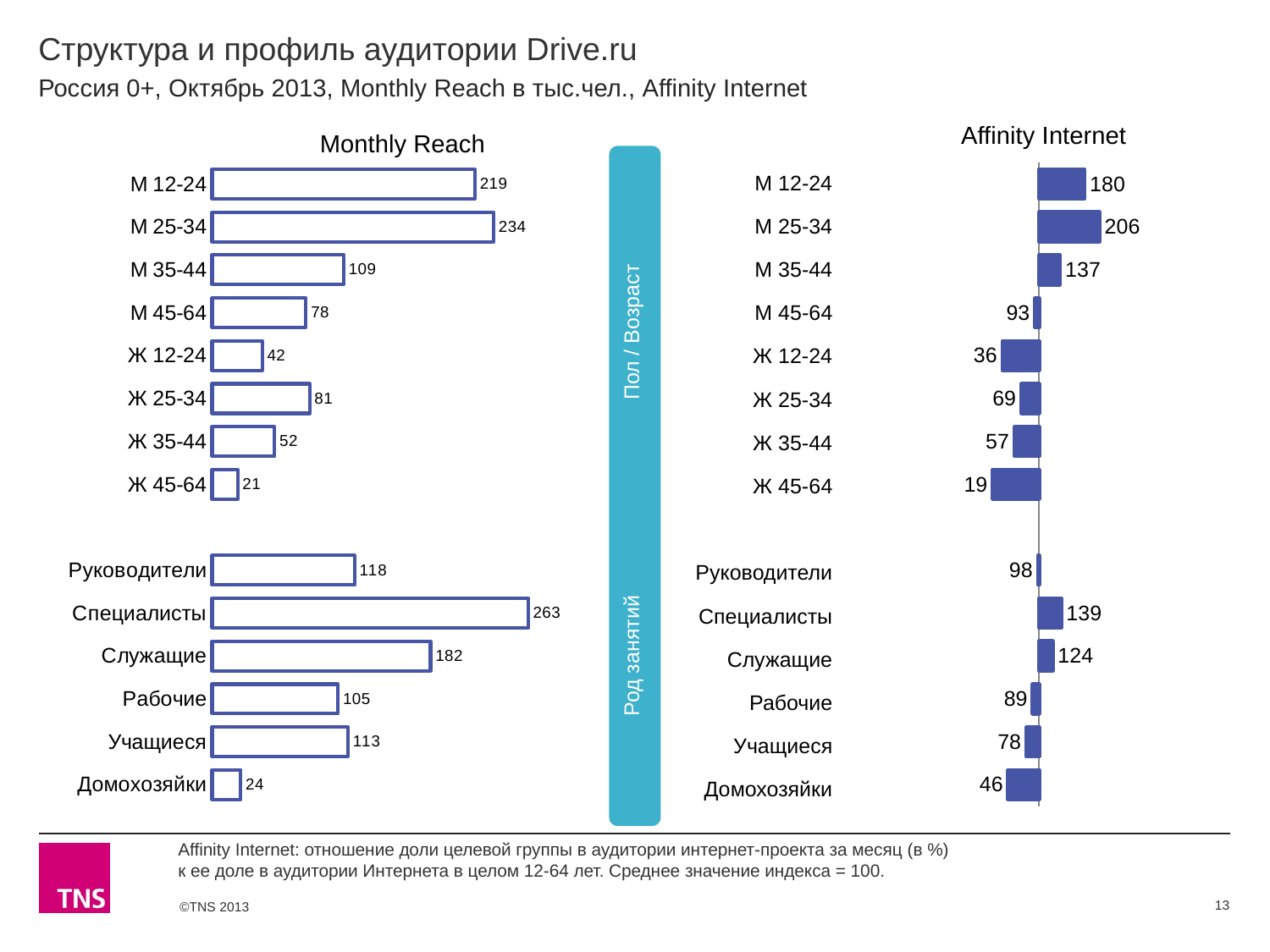
How many categories are plotted in the Monthly Reach chart? 14 In the Monthly Reach chart, what is the difference between Специалисты and Служащие? 81 In the Affinity Internet chart, what is the value for Ж 45-64? 19 What kind of chart is the Affinity Internet chart? Bar chart In the Affinity Internet chart, which category has the lowest value? Ж 45-64 In the Affinity Internet chart, which is larger: М 12-24 or М 25-34? М 25-34 In the Monthly Reach chart, what is the value for М 25-34? 234 In the Monthly Reach chart, which category has the highest value? Специалисты In the Affinity Internet chart, what is the value for Руководители? 98 In the Affinity Internet chart, what is the difference between Специалисты and Рабочие? 50 In the Monthly Reach chart, which is larger: Ж 25-34 or Ж 35-44? Ж 25-34 In the Monthly Reach chart, what is the value for Домохозяйки? 24